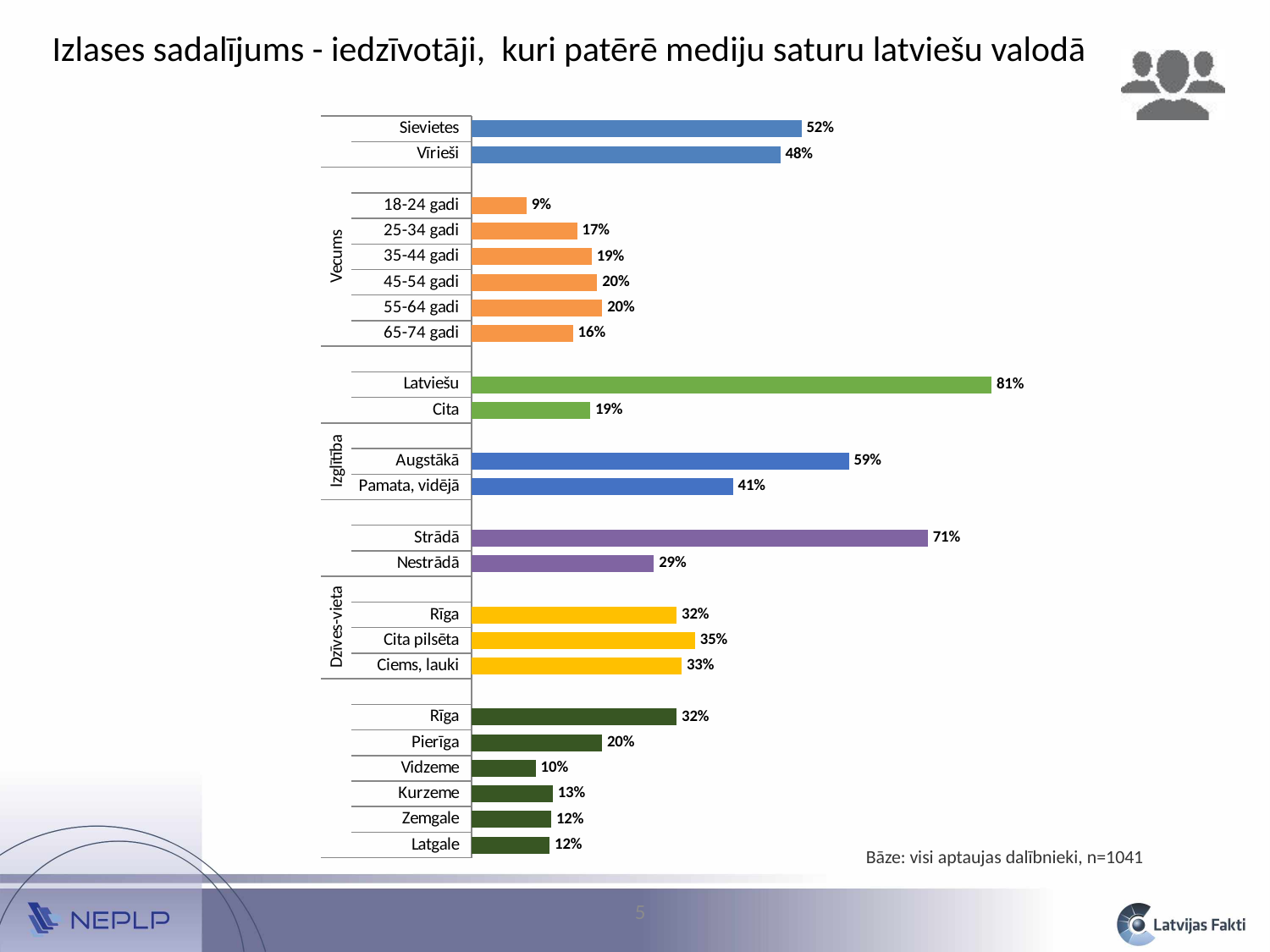
What type of chart is shown on the slide? Bar chart Which is larger, Augstākā or Pamata, vidējā? Augstākā What is the value for the 18-24 gadi age group? 9% Which age group (Vecums) has the lowest value? 18-24 gadi What is the value for Cita pilsēta? 35% What is the difference between Sievietes and Vīrieši? 4% What is the difference between Strādā and Nestrādā? 42% Which region in the bottom group has the lowest value? Vidzeme Which category has the highest value on the chart? Latviešu What is the value for Pamata, vidējā? 41% What is the value for Latviešu? 81% What is the value for Sievietes? 52%